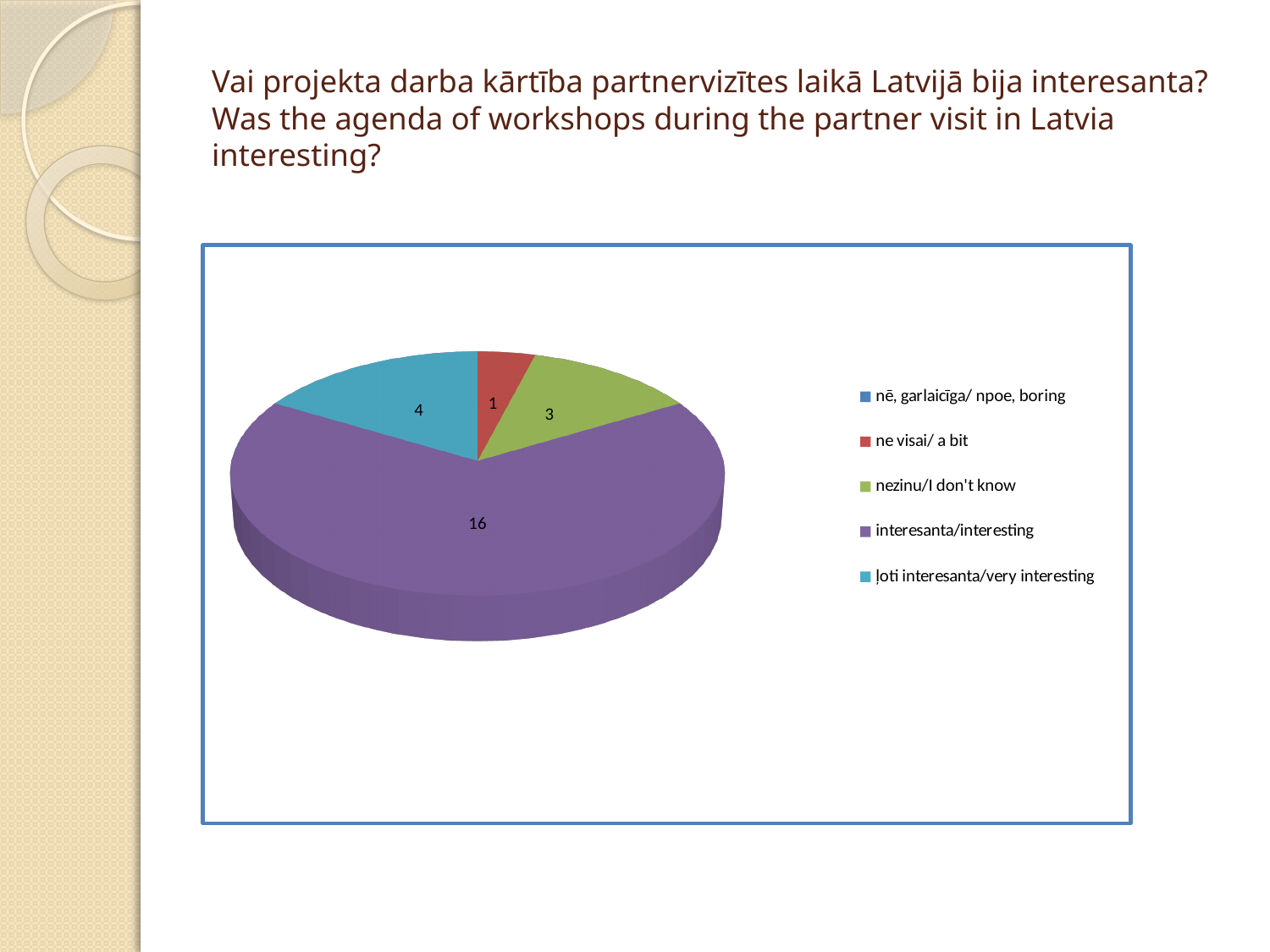
What value is shown for 'ne visai/ a bit'? 1 How many entries does the legend list? 5 What colour is the slice for 'interesanta/interesting'? purple How many responses were 'ļoti interesanta/very interesting'? 4 Which is larger: 'nezinu/I don't know' or 'ļoti interesanta/very interesting'? ļoti interesanta/very interesting What type of chart is shown on the slide? pie chart Which labelled slice has the smallest value? ne visai/ a bit Which response category has the largest slice of the pie? interesanta/interesting How many responses were 'interesanta/interesting'? 16 What value is shown for 'nezinu/I don't know'? 3 What is the difference between the 'interesanta/interesting' and 'ļoti interesanta/very interesting' values? 12 What is the difference between the 'nezinu/I don't know' and 'ne visai/ a bit' values? 2